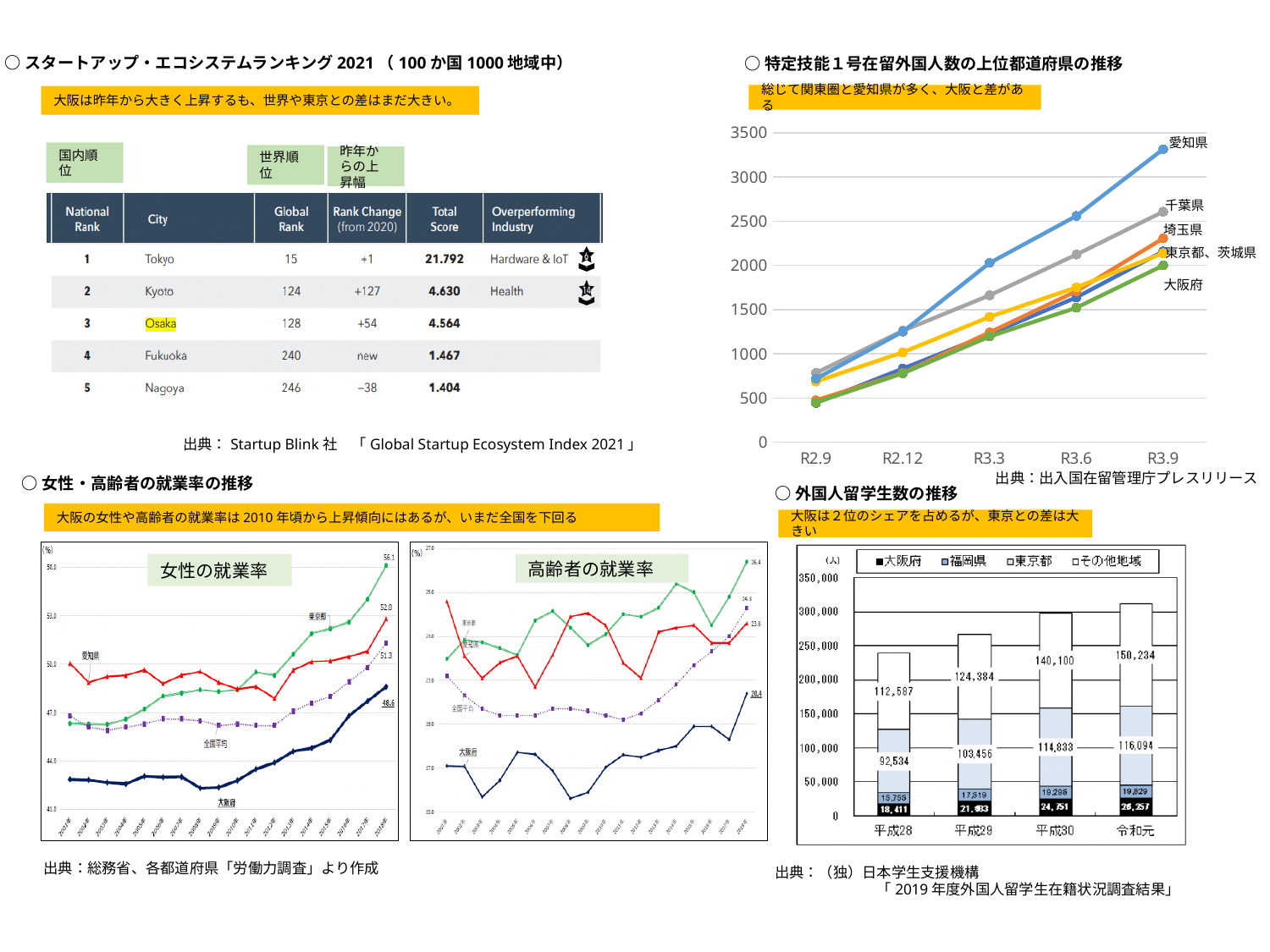
In the chart titled 外国人留学生数の推移, how many series does the legend list? 4 In the chart titled 外国人留学生数の推移, what is the difference between the その他地域 values for 令和元 and 平成28? 37,647 In the chart titled 特定技能１号在留外国人数の上位都道府県の推移, do the values for 愛知県 rise or fall from R2.9 to R3.9? rise In the chart titled 特定技能１号在留外国人数の上位都道府県の推移, how many points are on the x axis? 5 In the chart titled 外国人留学生数の推移, what kind of chart is it? stacked bar chart In the chart titled 特定技能１号在留外国人数の上位都道府県の推移, what kind of chart is it? line chart In the chart titled 特定技能１号在留外国人数の上位都道府県の推移, which prefecture has the highest value at R3.9? 愛知県 In the chart titled 外国人留学生数の推移, what is the value for 東京都 in 令和元? 116,094 In the chart titled 特定技能１号在留外国人数の上位都道府県の推移, is the value for 大阪府 at R2.9 greater or less than 500? less In the chart titled 特定技能１号在留外国人数の上位都道府県の推移, is the value for 愛知県 at R3.9 greater or less than 3000? greater In the chart titled 外国人留学生数の推移, what is the value for その他地域 in 平成30? 140,100 In the chart titled 外国人留学生数の推移, which is larger in 平成29: the value for 東京都 or the value for その他地域? その他地域